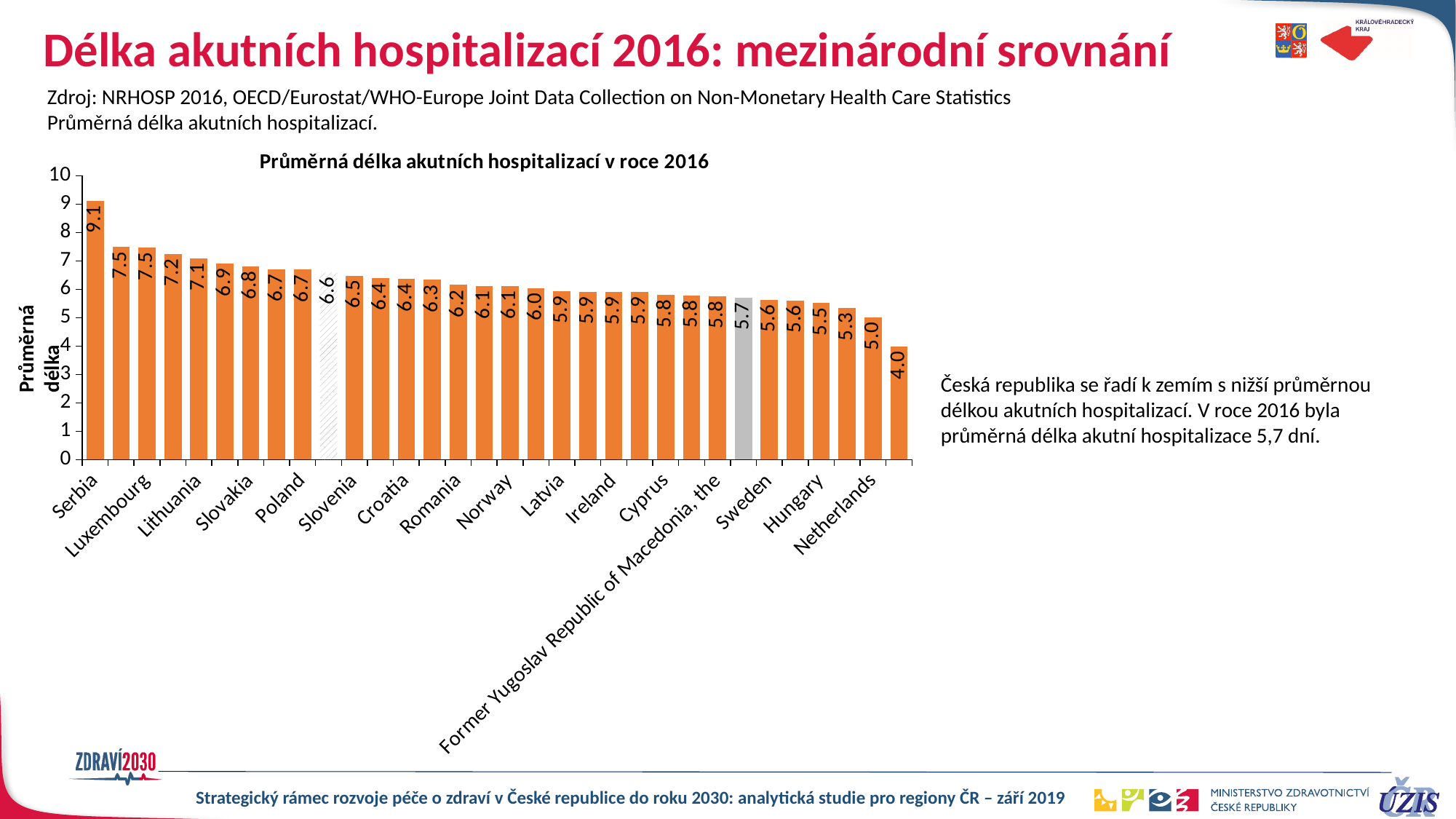
Which is larger, the value for Serbia or the value for Luxembourg? Serbia Which country has the highest average length of acute hospitalization in the chart? Serbia What kind of chart is shown on the slide? bar chart What is the lowest value shown in the chart? 4.0 What is the value for Serbia in the chart? 9.1 Do the values rise or fall from left to right along the x axis? fall What is the value for Luxembourg in the chart? 7.5 What is the difference between the highest and lowest values in the chart? 5.1 Is the value for Netherlands greater or less than 6? less What is the highest value shown in the chart? 9.1 Is the value for Serbia greater or less than 8? greater What is the value shown on the grey highlighted bar in the chart? 5.7